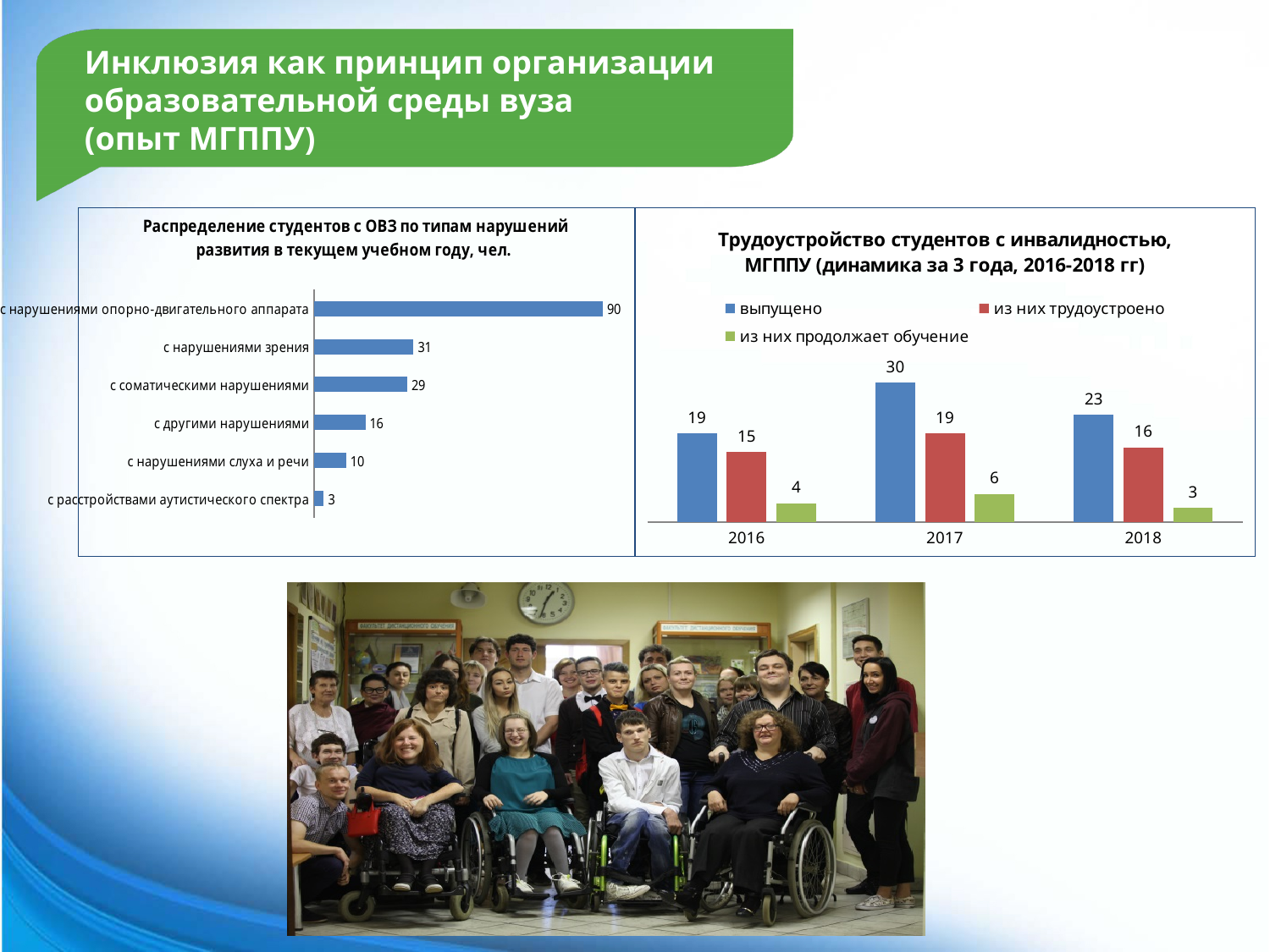
In the left chart 'Распределение студентов с ОВЗ по типам нарушений развития', what is the difference between 'с нарушениями опорно-двигательного аппарата' and 'с нарушениями зрения'? 59 What type of chart is the left chart 'Распределение студентов с ОВЗ по типам нарушений развития'? bar chart In the right chart 'Трудоустройство студентов с инвалидностью, МГППУ', which is larger: 'из них трудоустроено' in 2018 or 'из них трудоустроено' in 2016? 2018 In the left chart 'Распределение студентов с ОВЗ по типам нарушений развития в текущем учебном году, чел.', what is the value for 'с нарушениями зрения'? 31 In the right chart 'Трудоустройство студентов с инвалидностью, МГППУ', what is the value for 'из них трудоустроено' in 2017? 19 In the right chart 'Трудоустройство студентов с инвалидностью, МГППУ', what is the value for 'из них продолжает обучение' in 2018? 3 In the right chart 'Трудоустройство студентов с инвалидностью, МГППУ', in which year is 'выпущено' highest? 2017 In the left chart 'Распределение студентов с ОВЗ по типам нарушений развития', which category has the lowest value? с расстройствами аутистического спектра In the right chart 'Трудоустройство студентов с инвалидностью, МГППУ', what is the difference between 'выпущено' and 'из них трудоустроено' in 2016? 4 In the right chart 'Трудоустройство студентов с инвалидностью, МГППУ', how many series does the legend list? 3 In the left chart 'Распределение студентов с ОВЗ по типам нарушений развития', how many categories are shown? 6 In the left chart 'Распределение студентов с ОВЗ по типам нарушений развития', which category has the highest value? с нарушениями опорно-двигательного аппарата